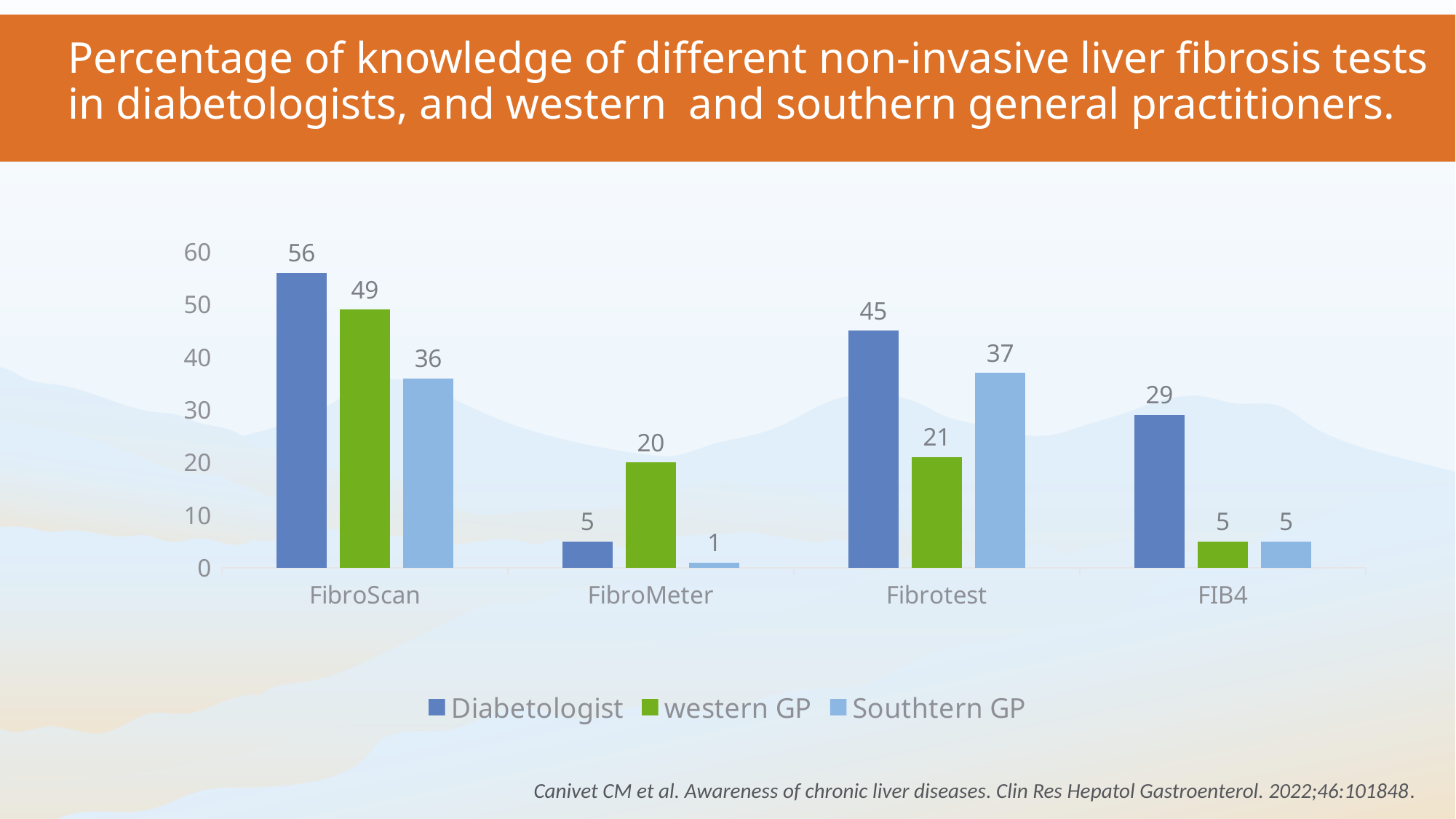
Which test has the highest Diabetologist value? FibroScan What is the value for Diabetologist for FibroScan? 56 What kind of chart is shown on the slide? Bar chart How many tests are shown on the x axis? 4 Which test has the lowest Southtern GP value? FibroMeter What is the difference between the Diabetologist and western GP values for Fibrotest? 24 How many series does the legend list? 3 What is the value for Southtern GP for Fibrotest? 37 Which colour represents the western GP series? Green What is the value for western GP for FibroMeter? 20 Which is larger for FibroScan: the western GP value or the Southtern GP value? western GP Is the Diabetologist value for FIB4 greater or less than 20? greater